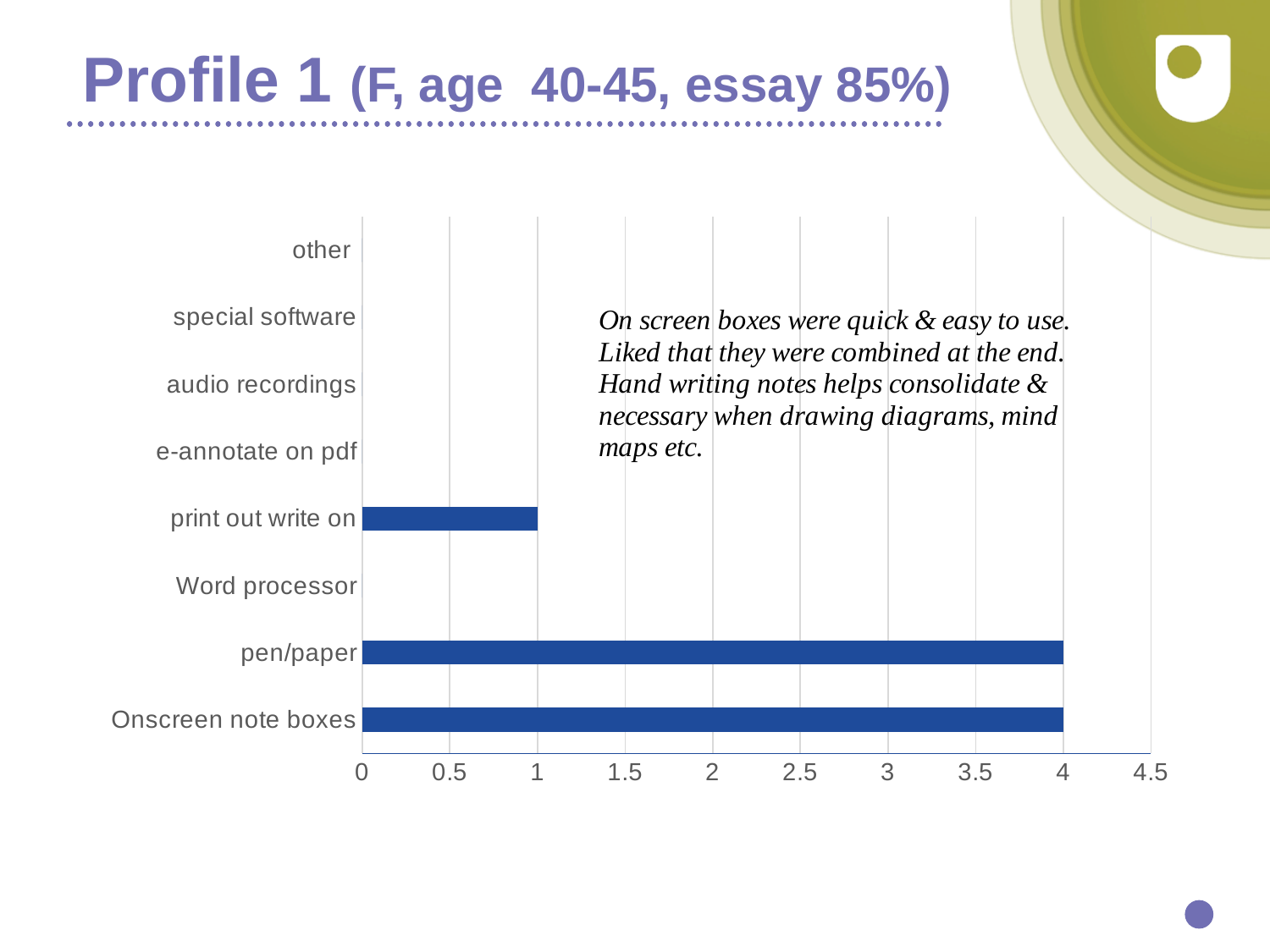
Is the value for Onscreen note boxes greater or less than 3? greater Which is larger, the value for pen/paper or the value for print out write on? pen/paper What kind of chart is shown on the slide? bar chart What colour are the bars in the chart? blue What is the value for pen/paper? 4 How many categories are shown on the chart? 8 What is the difference between the values for pen/paper and print out write on? 3 Is the value for print out write on greater or less than 2? less What is the value for Onscreen note boxes? 4 What is the value for print out write on? 1 How many categories have a visible bar on the chart? 3 What is the highest value shown on the x axis? 4.5